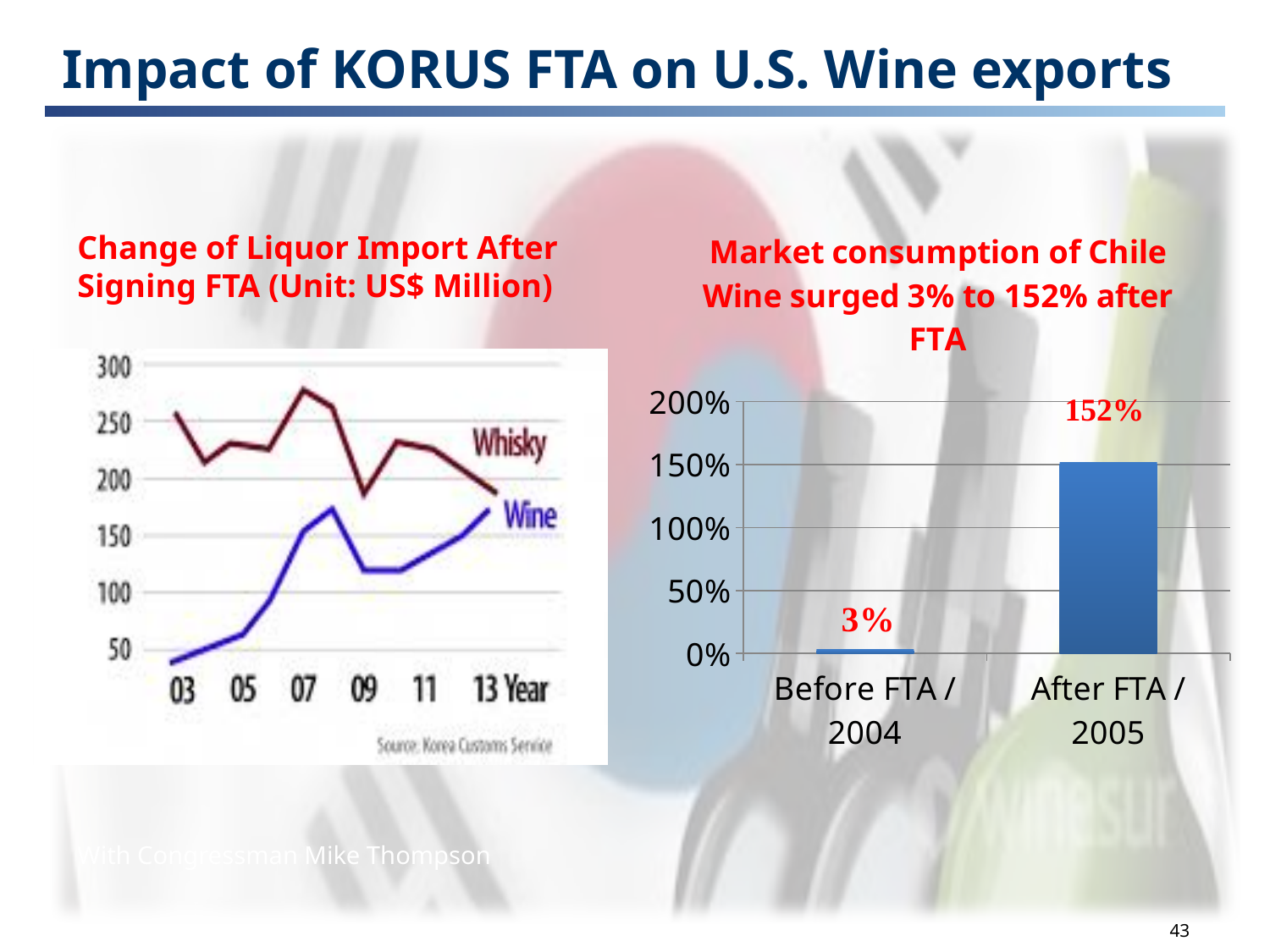
On the right chart, what is the value for Before FTA / 2004? 3% On the left chart, does the Wine series overall rise or fall from 03 to 13? rise On the right chart, what is the value for After FTA / 2005? 152% On the right chart, how many categories are shown on the x axis? 2 On the left chart, how many series are plotted? 2 On the right chart, what is the difference between the After FTA / 2005 value and the Before FTA / 2004 value? 149% On the right chart, which category has the higher value? After FTA / 2005 What kind of chart is the left chart (Change of Liquor Import After Signing FTA)? Line chart What kind of chart is the right chart? Bar chart On the left chart, which series is higher in 03, Whisky or Wine? Whisky On the left chart, is the Whisky value in 03 greater or less than 200? greater On the left chart, is the Wine value in 03 greater or less than 100? less